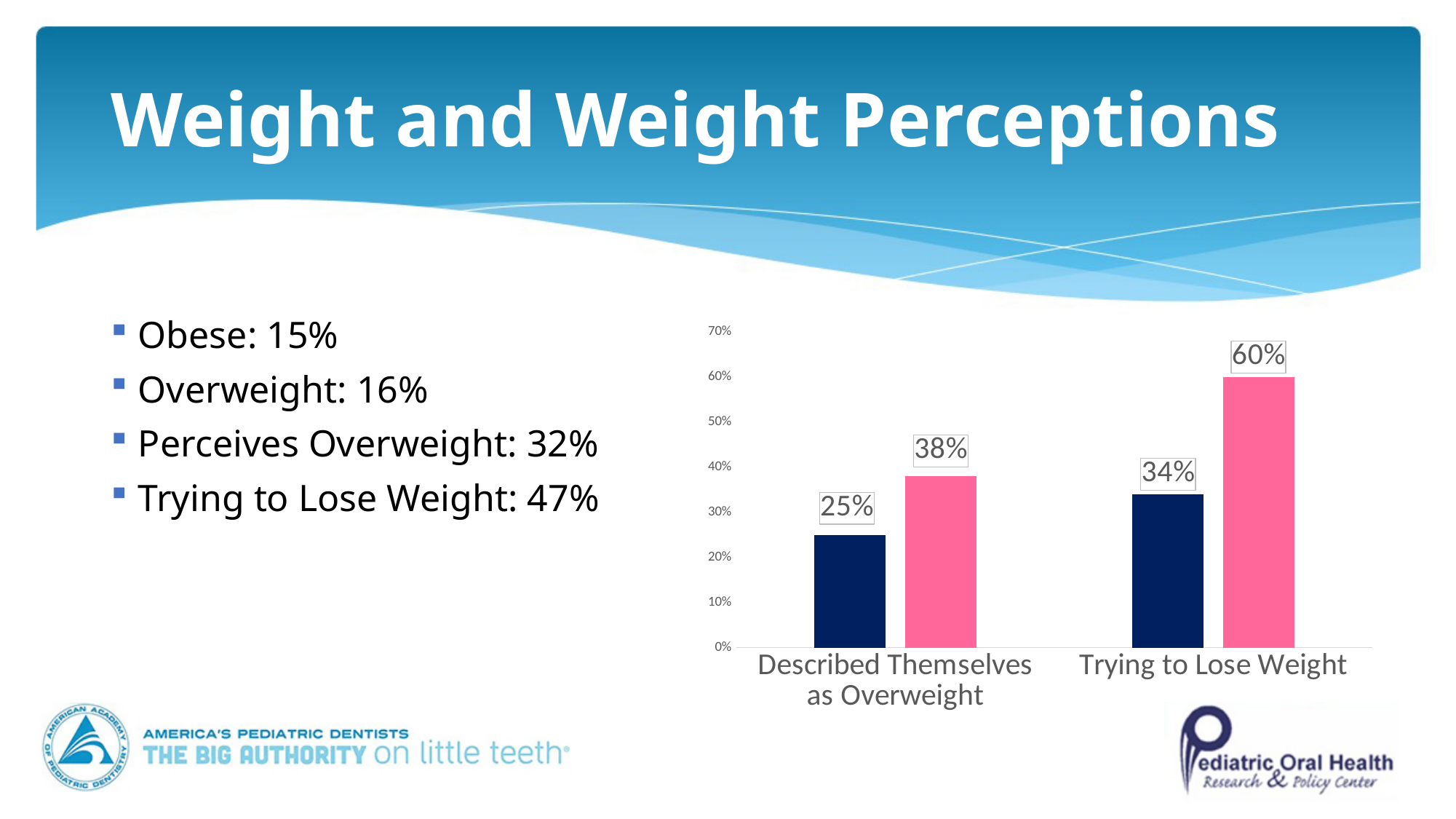
What is the difference between the pink and dark blue bars for "Described Themselves as Overweight"? 13% What is the value of the dark blue bar for "Described Themselves as Overweight"? 25% What type of chart is shown on the slide? Bar chart What is the value of the pink bar for "Described Themselves as Overweight"? 38% Which bar in the chart has the highest value? The pink bar for Trying to Lose Weight (60%) How many categories are shown on the x axis of the chart? 2 What is the value of the pink bar for "Trying to Lose Weight"? 60% Which bar in the chart has the lowest value? The dark blue bar for Described Themselves as Overweight (25%) Is the pink bar for "Trying to Lose Weight" greater or less than 50%? greater What is the difference between the pink and dark blue bars for "Trying to Lose Weight"? 26% What is the value of the dark blue bar for "Trying to Lose Weight"? 34% Which is larger: the dark blue bar for "Trying to Lose Weight" or the pink bar for "Described Themselves as Overweight"? The pink bar for Described Themselves as Overweight (38%)